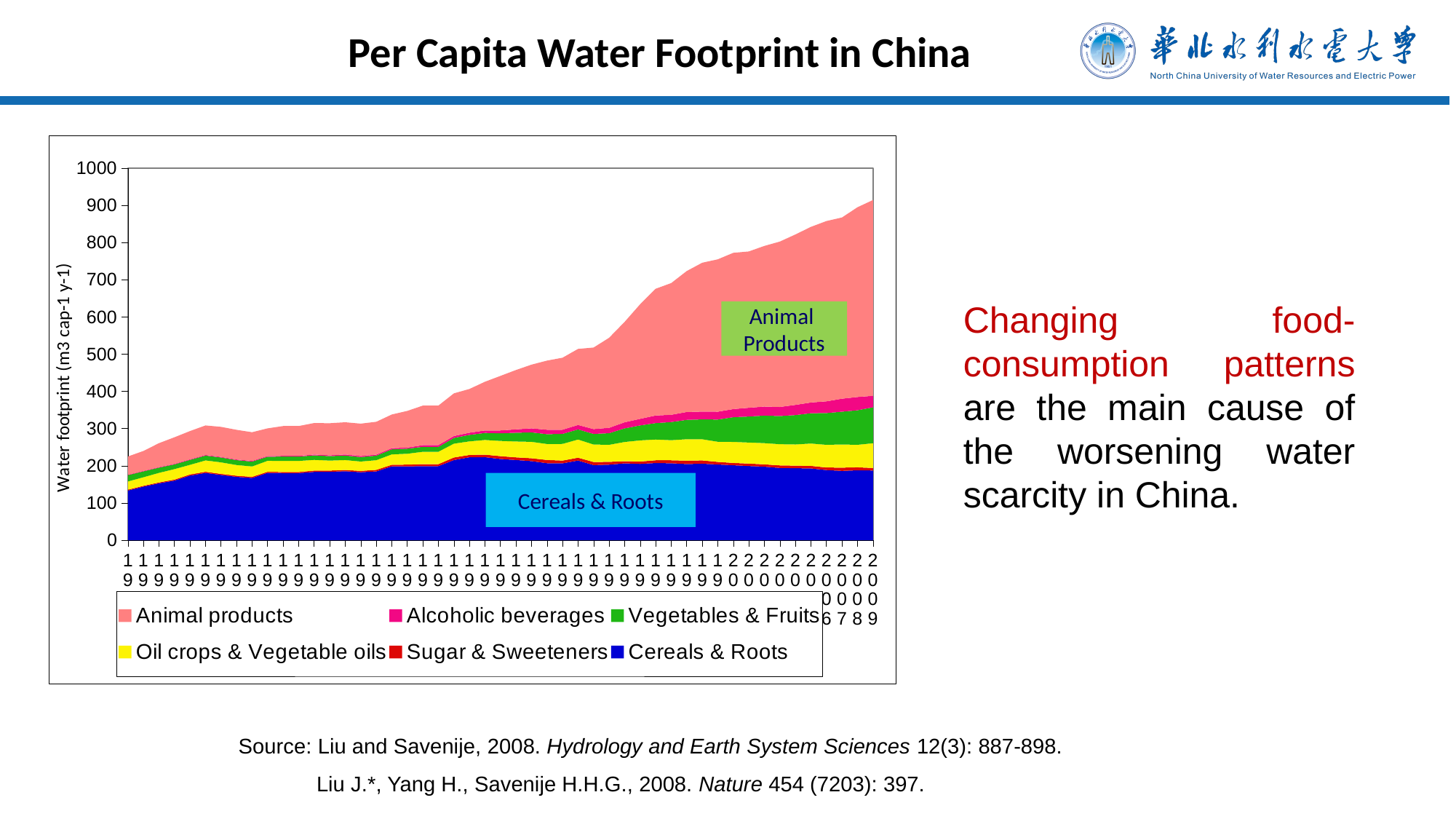
Does the total per capita water footprint rise or fall over the years shown on the x axis? Rise In the final year shown, which is larger: the Animal products band or the Cereals & Roots band? Animal products Is the total water footprint in the final year shown greater or less than 1000? less Which series contributes the largest share of the water footprint in the final year shown? Animal products Is the total water footprint in the first year shown greater or less than 300? less What kind of chart is shown on the slide? Stacked area chart How many series does the chart's legend list? 6 Is the Cereals & Roots value in the first year shown greater or less than 200? less What is the label of the y axis of the chart? Water footprint (m3 cap-1 y-1) Which series is plotted at the bottom of the stack in the chart? Cereals & Roots Which series contributes the largest share of the water footprint in the first year shown? Cereals & Roots